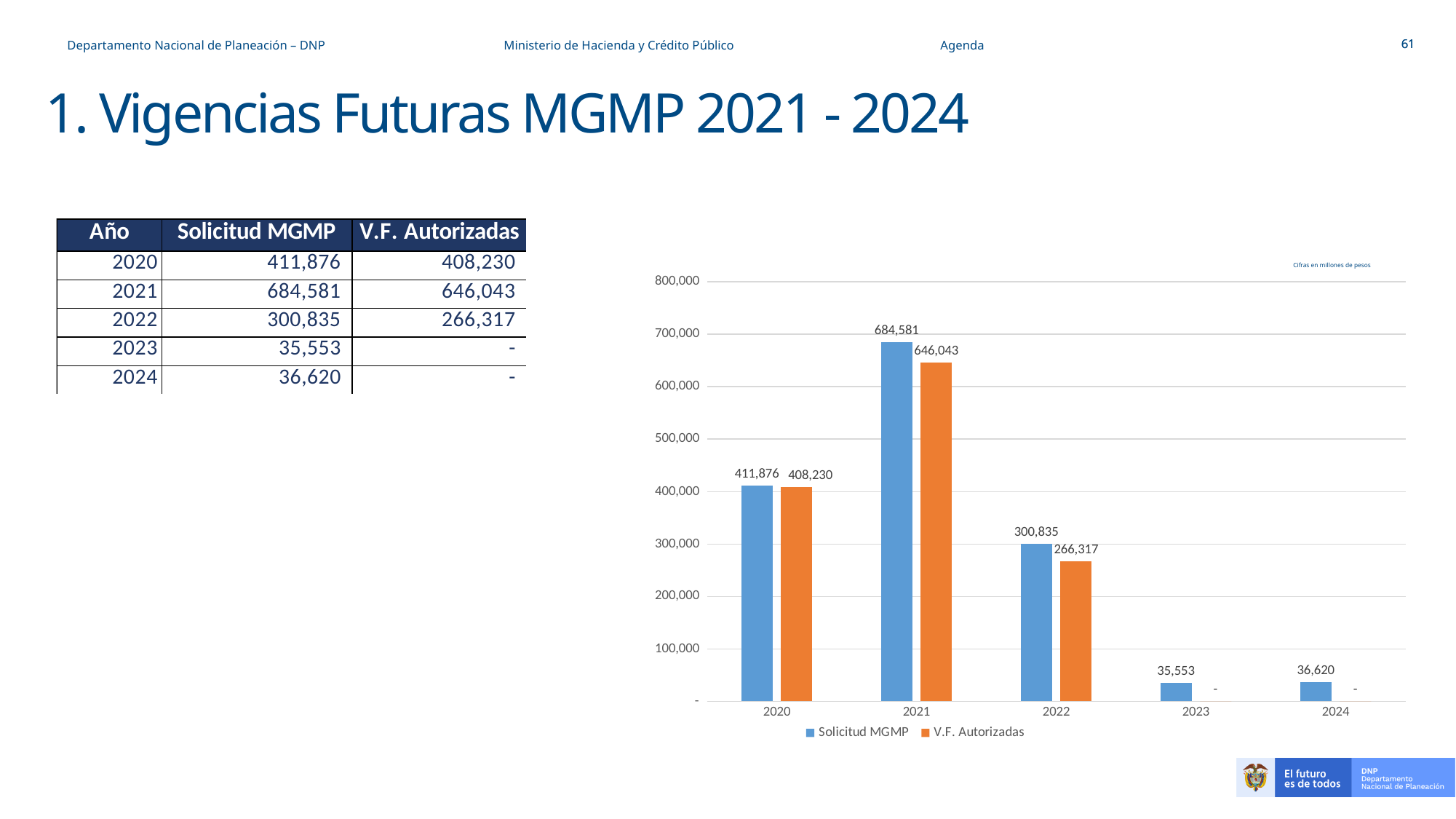
How many series does the chart legend list? 2 Which year has the lowest Solicitud MGMP value? 2023 Is the V.F. Autorizadas value for 2021 greater or less than 600,000? greater What kind of chart is shown on the slide? bar chart What is the difference between Solicitud MGMP and V.F. Autorizadas in 2020? 3,646 What is the V.F. Autorizadas value for 2022? 266,317 What is the difference between Solicitud MGMP and V.F. Autorizadas in 2021? 38,538 What is the Solicitud MGMP value for 2021? 684,581 Which is larger, the Solicitud MGMP value for 2022 or the V.F. Autorizadas value for 2022? Solicitud MGMP What is the Solicitud MGMP value for 2024? 36,620 How many years are shown on the x axis of the chart? 5 Which year has the highest Solicitud MGMP value? 2021